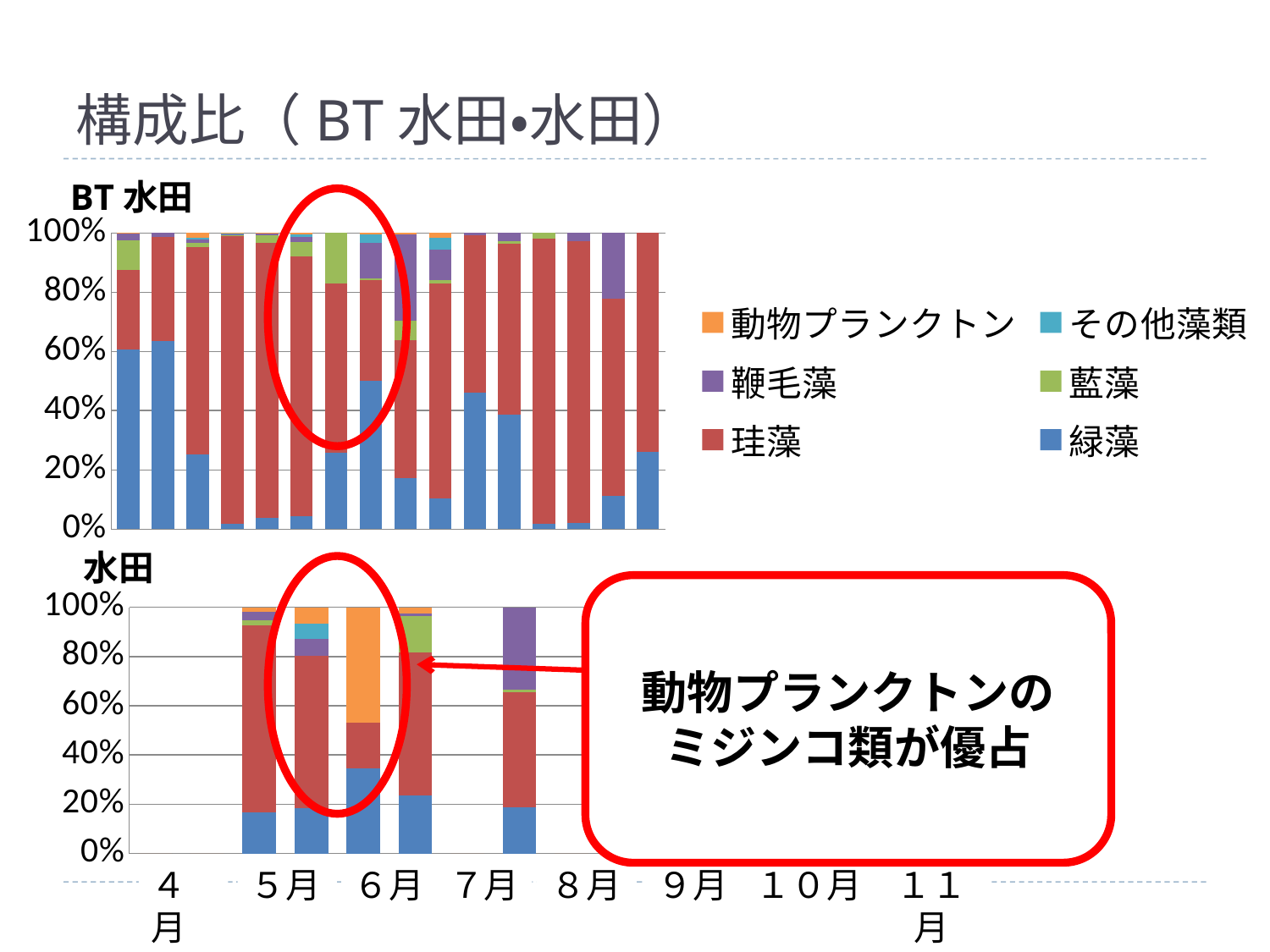
What kind of chart is the BT 水田 chart? stacked bar chart In the BT 水田 chart, is the 緑藻 value in the first bar greater or less than 50%? greater In the BT 水田 chart, which series occupies the largest share in most of the bars? 珪藻 In the 水田 chart, is the 緑藻 value in the first bar greater or less than 40%? less In the 水田 chart, is the 緑藻 value in the third bar (6月) greater or less than 20%? greater Which series is shown in orange in the legend? 動物プランクトン What is the maximum value shown on the y axis of the 水田 chart? 100% In the BT 水田 chart, which is larger in the first bar: the 緑藻 share or the 珪藻 share? 緑藻 In the 水田 chart, which series occupies the largest share of the third bar (6月)? 動物プランクトン Which series is shown in blue at the bottom of the stacked bars? 緑藻 How many series does the legend list for the charts? 6